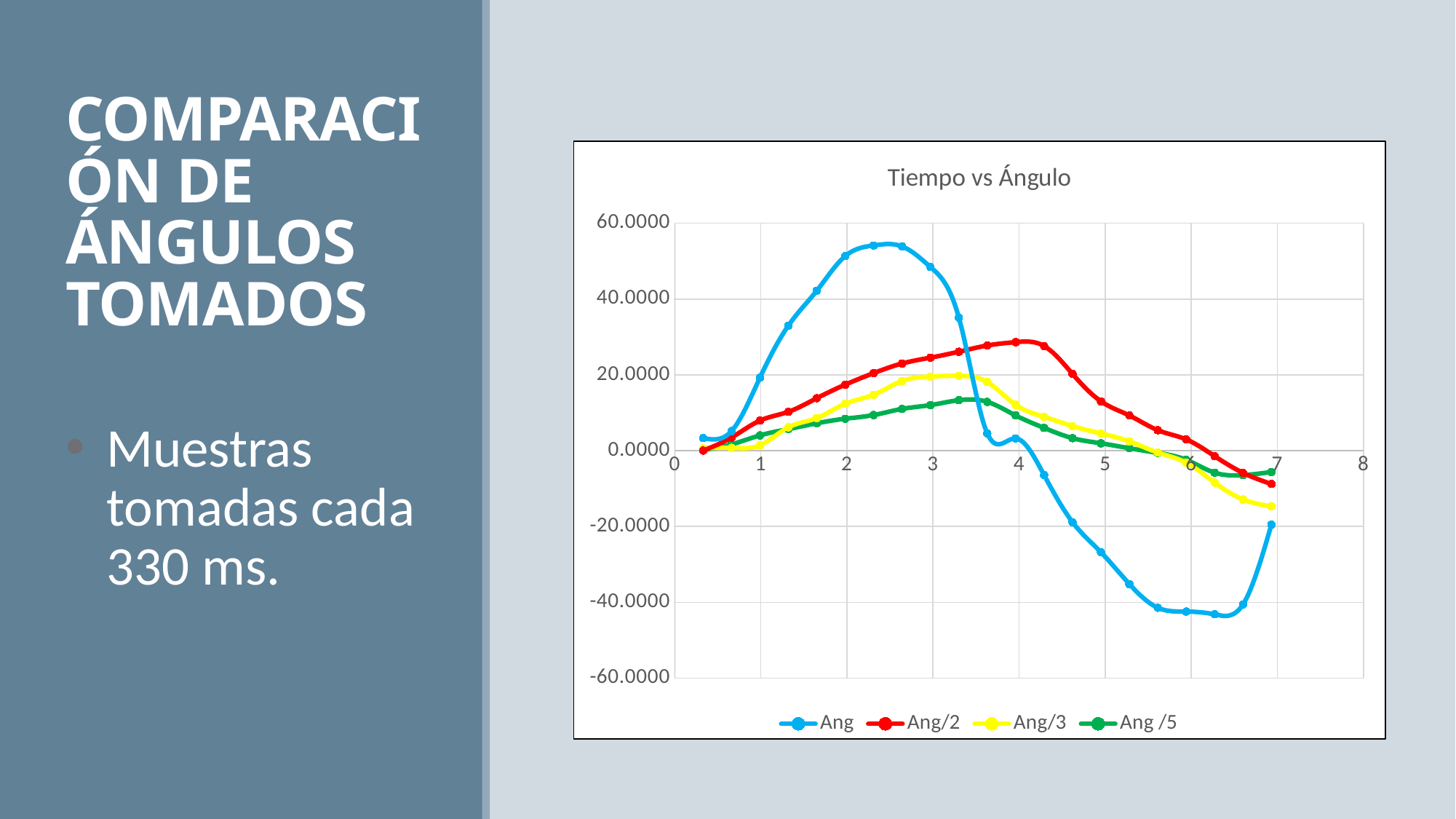
Is the peak value of the Ang /5 series greater or less than 20? less Is the value of the Ang/3 series at x = 7 greater or less than 0? less Is the lowest value of the Ang series greater or less than -40? less At x = 5, which series has the larger value, Ang or Ang/2? Ang/2 Which series reaches the highest value in the chart? Ang What is the title of the chart? Tiempo vs Ángulo Which colour is used for the Ang/2 series in the chart? red Does the Ang series rise or fall between x = 3 and x = 4? fall What kind of chart is shown on the slide? line chart How many series does the legend of the chart list? 4